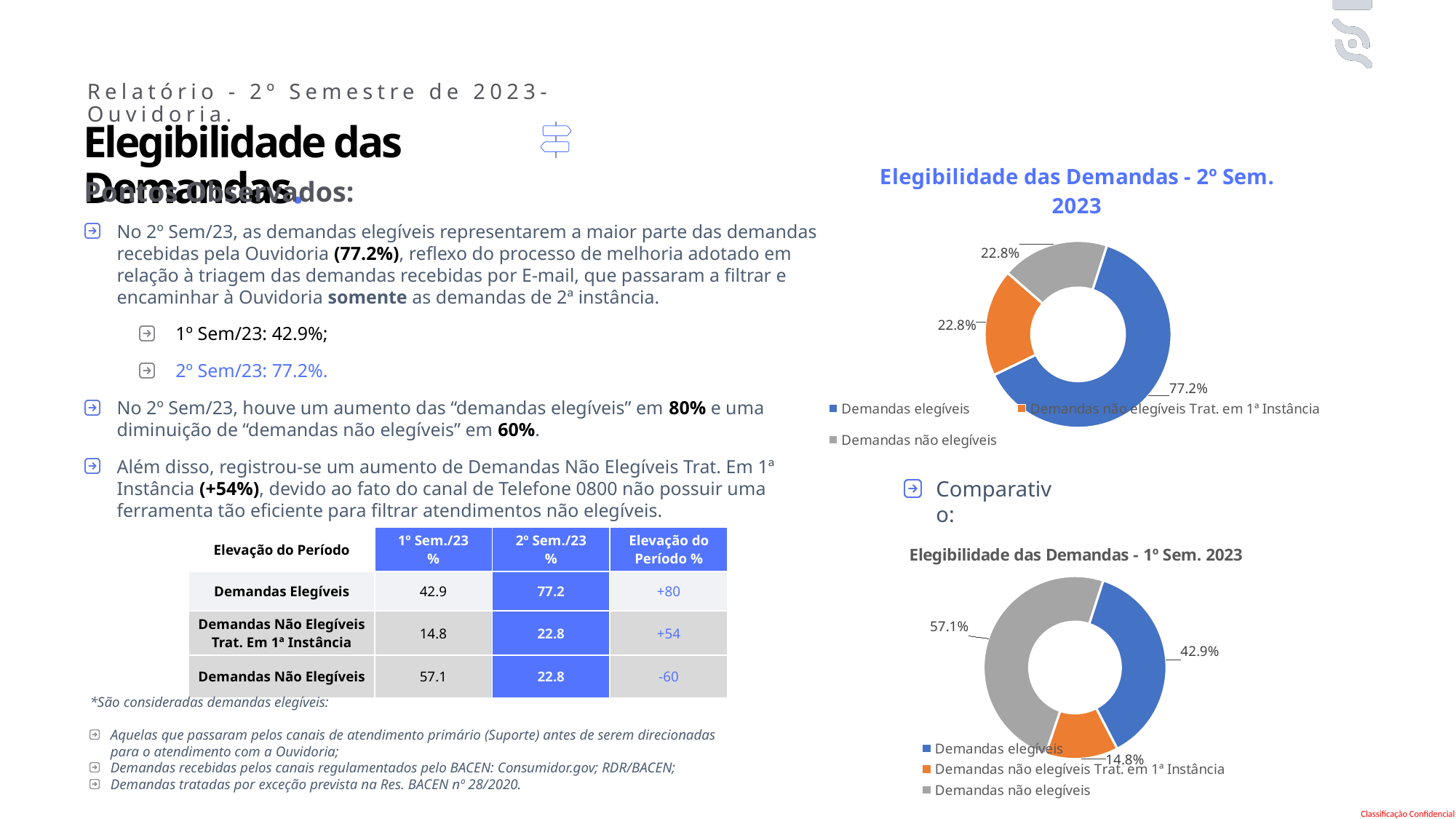
What kind of chart is "Elegibilidade das Demandas - 2º Sem. 2023"? Doughnut (pie) chart In the chart "Elegibilidade das Demandas - 1º Sem. 2023", what is the value labelled for Demandas elegíveis? 42.9% In the chart "Elegibilidade das Demandas - 1º Sem. 2023", which is larger: Demandas elegíveis or Demandas não elegíveis? Demandas não elegíveis In the chart "Elegibilidade das Demandas - 1º Sem. 2023", which category has the smallest slice? Demandas não elegíveis Trat. em 1ª Instância In the chart "Elegibilidade das Demandas - 1º Sem. 2023", which category has the largest slice? Demandas não elegíveis In the chart "Elegibilidade das Demandas - 1º Sem. 2023", what colour is the Demandas não elegíveis slice? Gray In the chart "Elegibilidade das Demandas - 2º Sem. 2023", which category has the largest slice? Demandas elegíveis In the chart "Elegibilidade das Demandas - 1º Sem. 2023", what is the difference between Demandas não elegíveis (57.1%) and Demandas elegíveis (42.9%)? 14.2% How many categories does the legend of "Elegibilidade das Demandas - 2º Sem. 2023" list? 3 In the chart "Elegibilidade das Demandas - 1º Sem. 2023", what is the value labelled for Demandas não elegíveis Trat. em 1ª Instância? 14.8% In the chart "Elegibilidade das Demandas - 2º Sem. 2023", what is the value labelled for Demandas não elegíveis? 22.8% In the chart "Elegibilidade das Demandas - 2º Sem. 2023", what is the value labelled for Demandas elegíveis? 77.2%